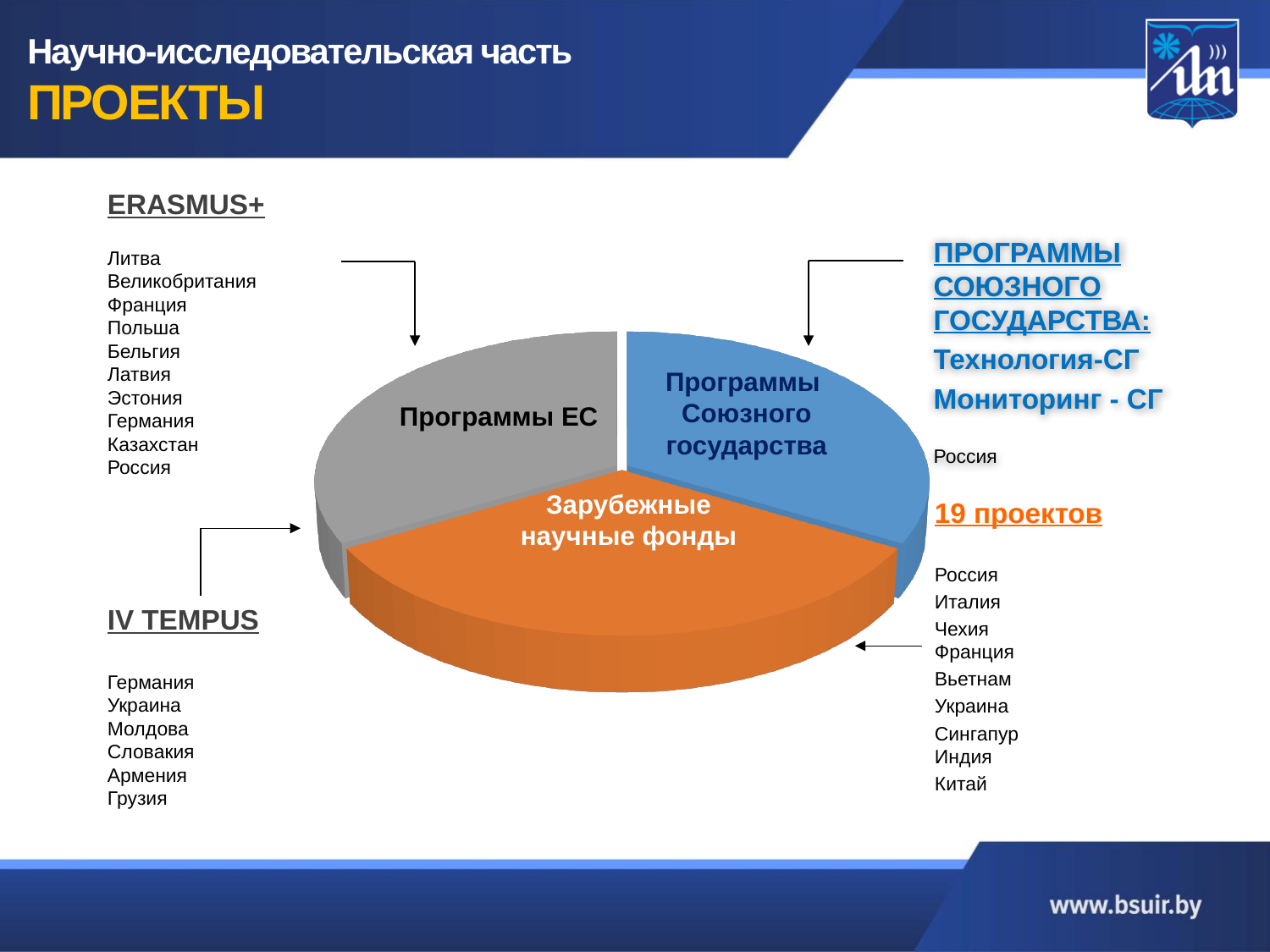
Which slice of the pie chart is coloured orange? Зарубежные научные фонды What kind of chart is shown on the slide? pie chart How many slices does the pie chart have? 3 What colour is the slice labelled Программы ЕС? grey What colour is the slice labelled Программы Союзного государства? blue